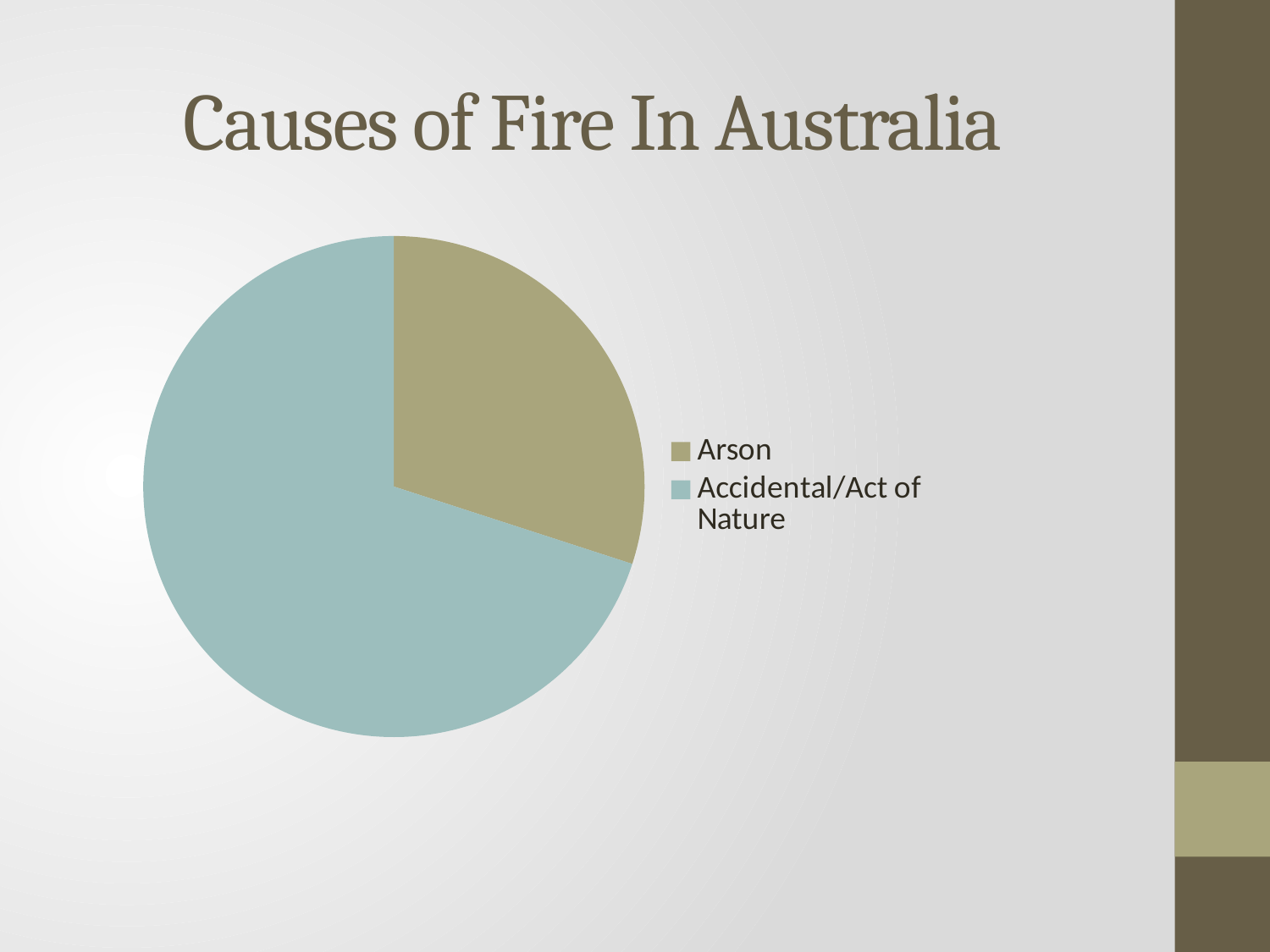
What kind of chart is shown on the slide? pie chart Which cause of fire has the largest slice of the pie? Accidental/Act of Nature Which legend entry is shown in the blue-green colour? Accidental/Act of Nature How many entries does the legend list? 2 Which slice is larger, Arson or Accidental/Act of Nature? Accidental/Act of Nature How many slices does the pie chart have? 2 Which cause of fire has the smallest slice of the pie? Arson What is the title of the slide containing the pie chart? Causes of Fire In Australia